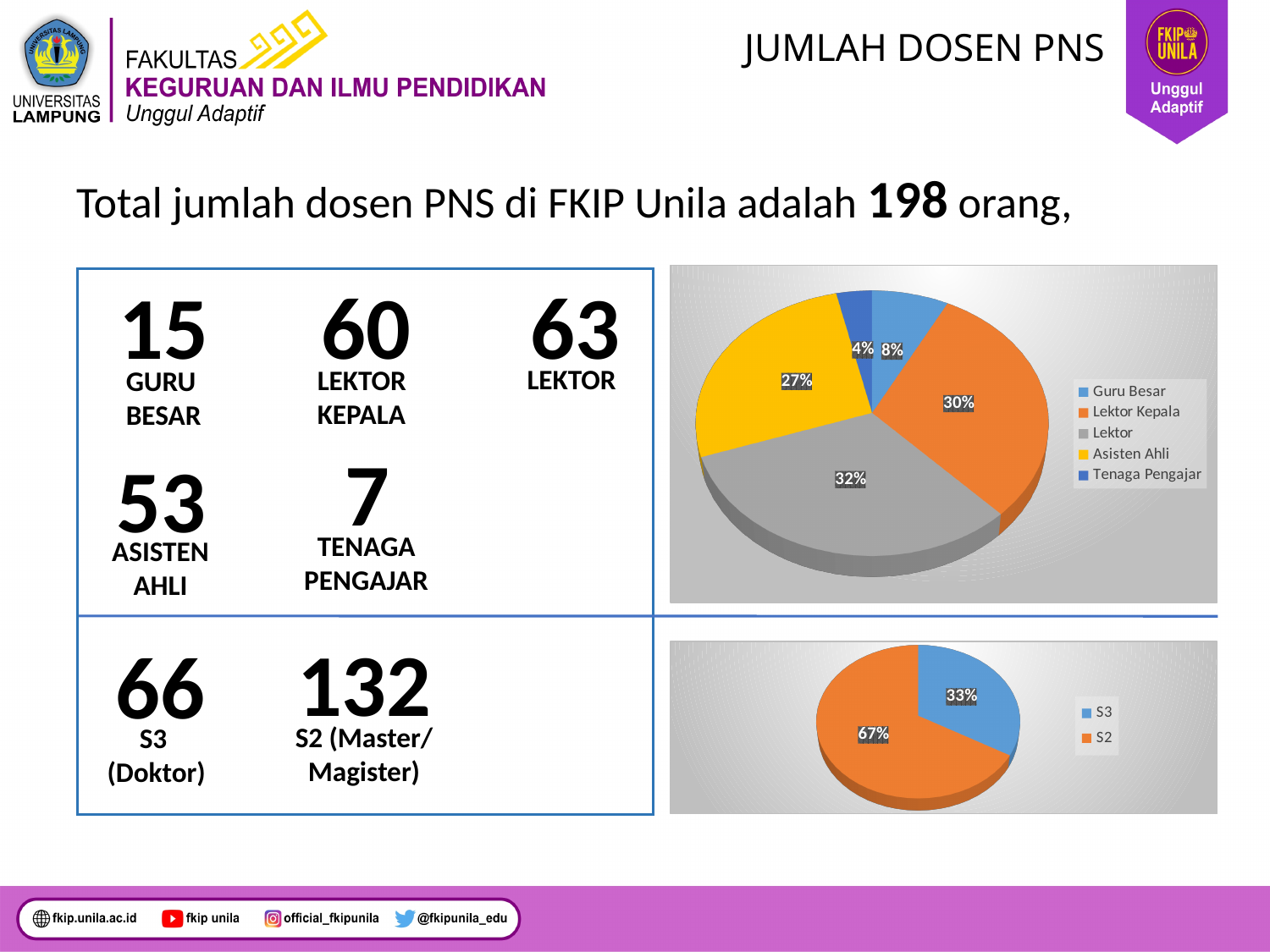
In the top pie chart, what is the difference in percentage points between Lektor Kepala and Guru Besar? 22 In the bottom pie chart, what share does S3 have? 33% What kind of chart is the bottom chart? Pie chart In the top pie chart, what colour is the Asisten Ahli slice? Yellow In the top pie chart, what share does Lektor have? 32% In the top pie chart, which is larger, Lektor Kepala or Asisten Ahli? Lektor Kepala In the top pie chart, what share does Tenaga Pengajar have? 4% In the top pie chart, which category has the smallest slice? Tenaga Pengajar In the top pie chart, which category has the largest slice? Lektor In the top pie chart, how many categories does the legend list? 5